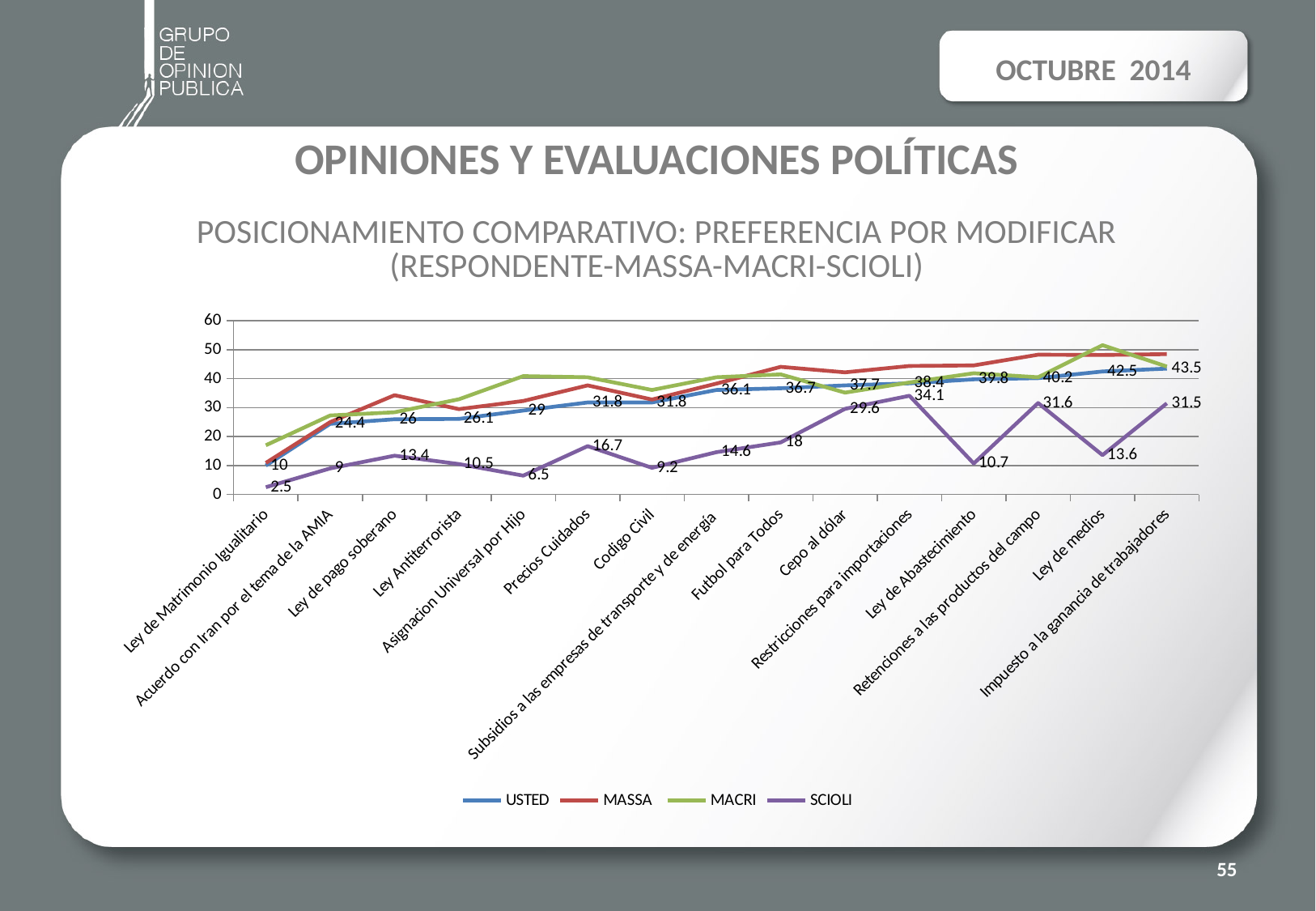
How many series does the legend list? 4 What is the USTED value for Impuesto a la ganancia de trabajadores? 43.5 How many categories are plotted along the x axis? 15 What is the SCIOLI value for Restricciones para importaciones? 34.1 For which category is the USTED value highest? Impuesto a la ganancia de trabajadores Does the USTED series generally rise or fall from left to right along the x axis? rise What is the difference between the USTED and SCIOLI values for Cepo al dólar? 8.1 Is the MACRI value for Ley de medios greater or less than 50? greater For which category is the SCIOLI value lowest? Ley de Matrimonio Igualitario What is the USTED value for Ley de Matrimonio Igualitario? 10 What is the SCIOLI value for Ley de medios? 13.6 What type of chart is shown on the slide? line chart